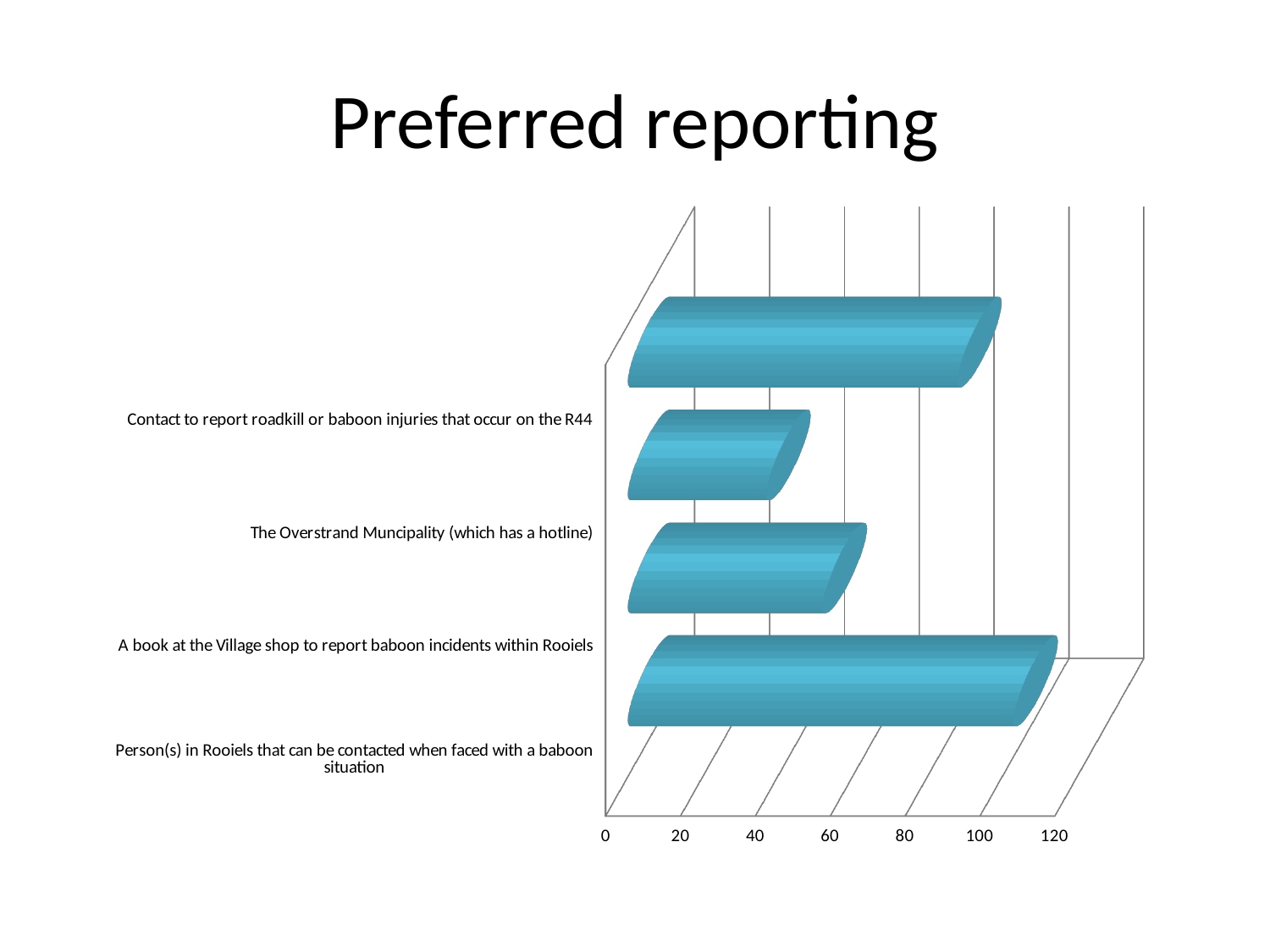
Which category has the lowest value? The Overstrand Muncipality (which has a hotline) How many categories are plotted in the chart? 4 Is the value for 'A book at the Village shop to report baboon incidents within Rooiels' greater or less than 40? greater Which category has the highest value? Person(s) in Rooiels that can be contacted when faced with a baboon situation Which is larger: the value for 'A book at the Village shop to report baboon incidents within Rooiels' or the value for 'The Overstrand Muncipality (which has a hotline)'? A book at the Village shop to report baboon incidents within Rooiels What is the title of the chart? Preferred reporting Is the value for 'Person(s) in Rooiels that can be contacted when faced with a baboon situation' greater or less than 100? greater What kind of chart is shown on the slide? bar chart Is the value for 'The Overstrand Muncipality (which has a hotline)' greater or less than 80? less Which is larger: the value for 'Person(s) in Rooiels that can be contacted when faced with a baboon situation' or the value for 'Contact to report roadkill or baboon injuries that occur on the R44'? Person(s) in Rooiels that can be contacted when faced with a baboon situation